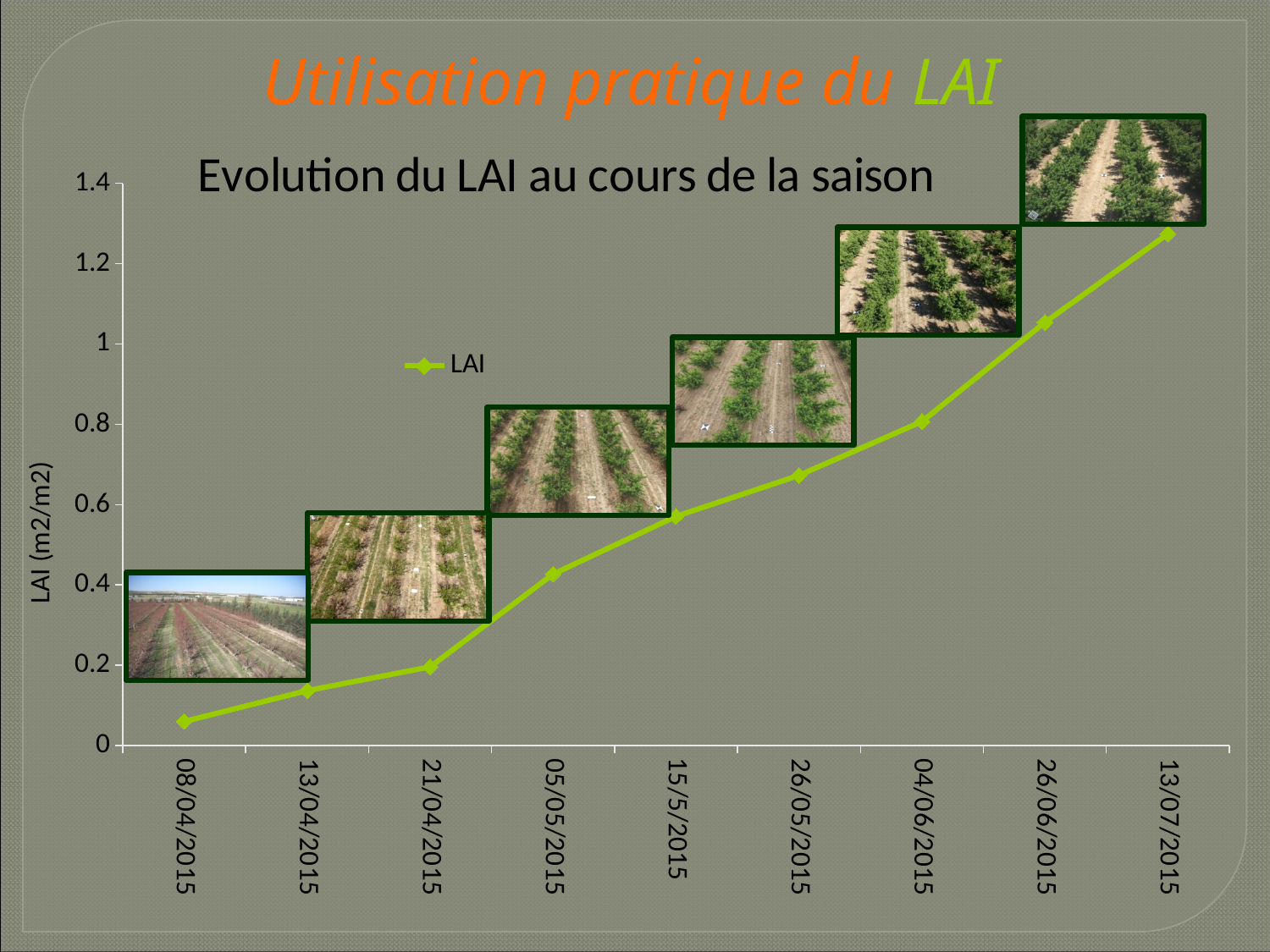
Which date has the larger LAI value, 05/05/2015 or 04/06/2015? 04/06/2015 On which date is the LAI value highest? 13/07/2015 Is the LAI value for 13/07/2015 greater or less than 1.2? greater Do the LAI values rise or fall from 08/04/2015 to 13/07/2015? rise What is the title of the chart? Evolution du LAI au cours de la saison How many series does the legend list? 1 On which date is the LAI value lowest? 08/04/2015 What type of chart is shown on the slide? line chart Is the LAI value for 26/05/2015 greater or less than 0.6? greater Is the LAI value for 08/04/2015 greater or less than 0.2? less How many dates are plotted on the x axis? 9